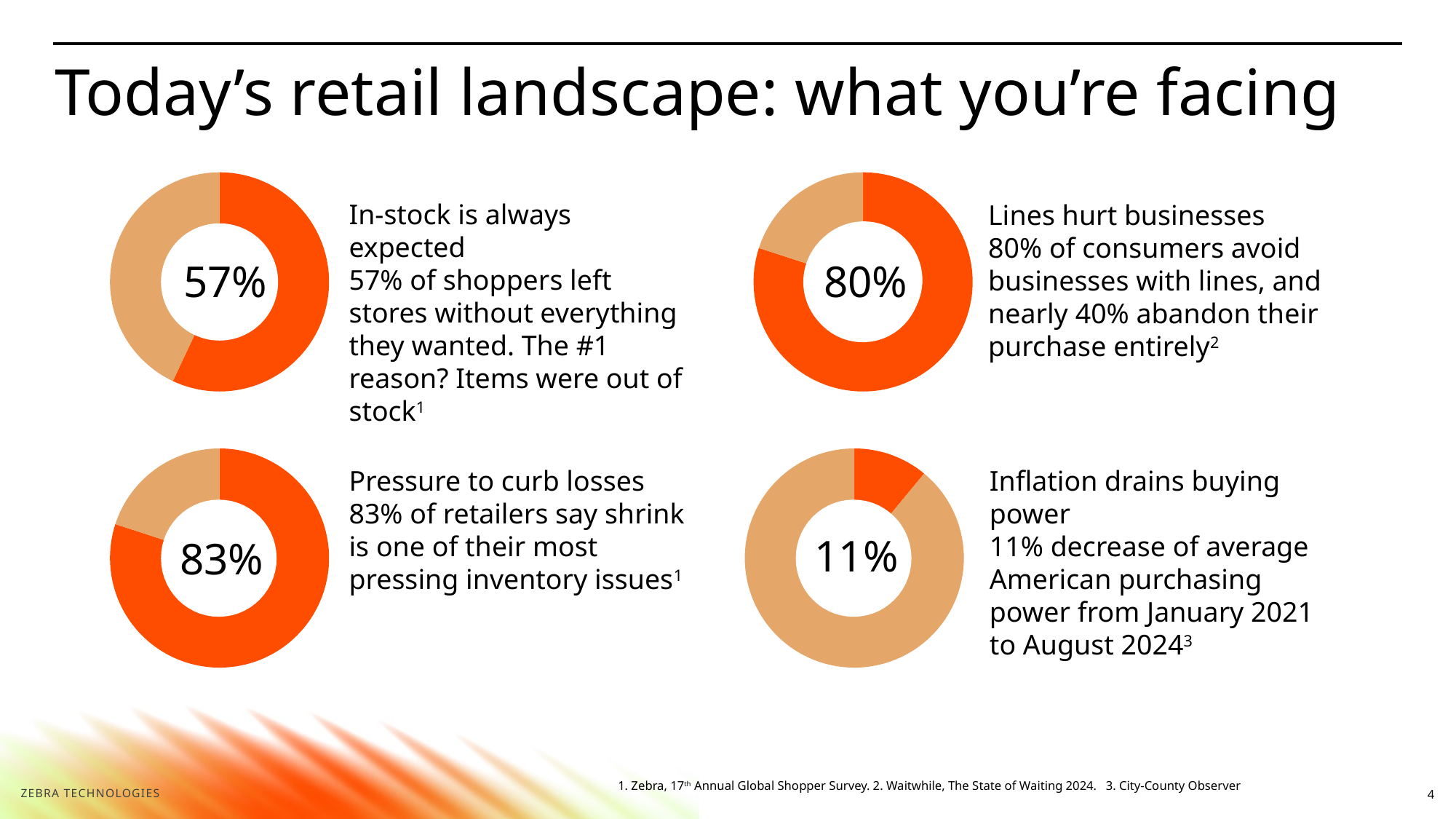
What percentage is shown in the centre of the bottom-left donut chart? 83% What is the difference between the percentage in the bottom-left donut chart and the percentage in the top-left donut chart? 26 percentage points What percentage is shown in the centre of the top-right donut chart? 80% What percentage is shown in the centre of the top-left donut chart? 57% How many slices does each donut chart have? 2 Which of the four donut charts shows the highest percentage? The bottom-left chart (83%) What percentage is shown in the centre of the bottom-right donut chart? 11% Which is larger: the percentage in the top-right donut chart or the percentage in the top-left donut chart? The top-right chart (80%) Which of the four donut charts shows the lowest percentage? The bottom-right chart (11%) How many donut charts are on the slide? 4 What kind of chart is used for each of the four statistics on the slide? Donut (pie) chart In the top-right donut chart, what share of the ring does the dark orange slice represent? 80%